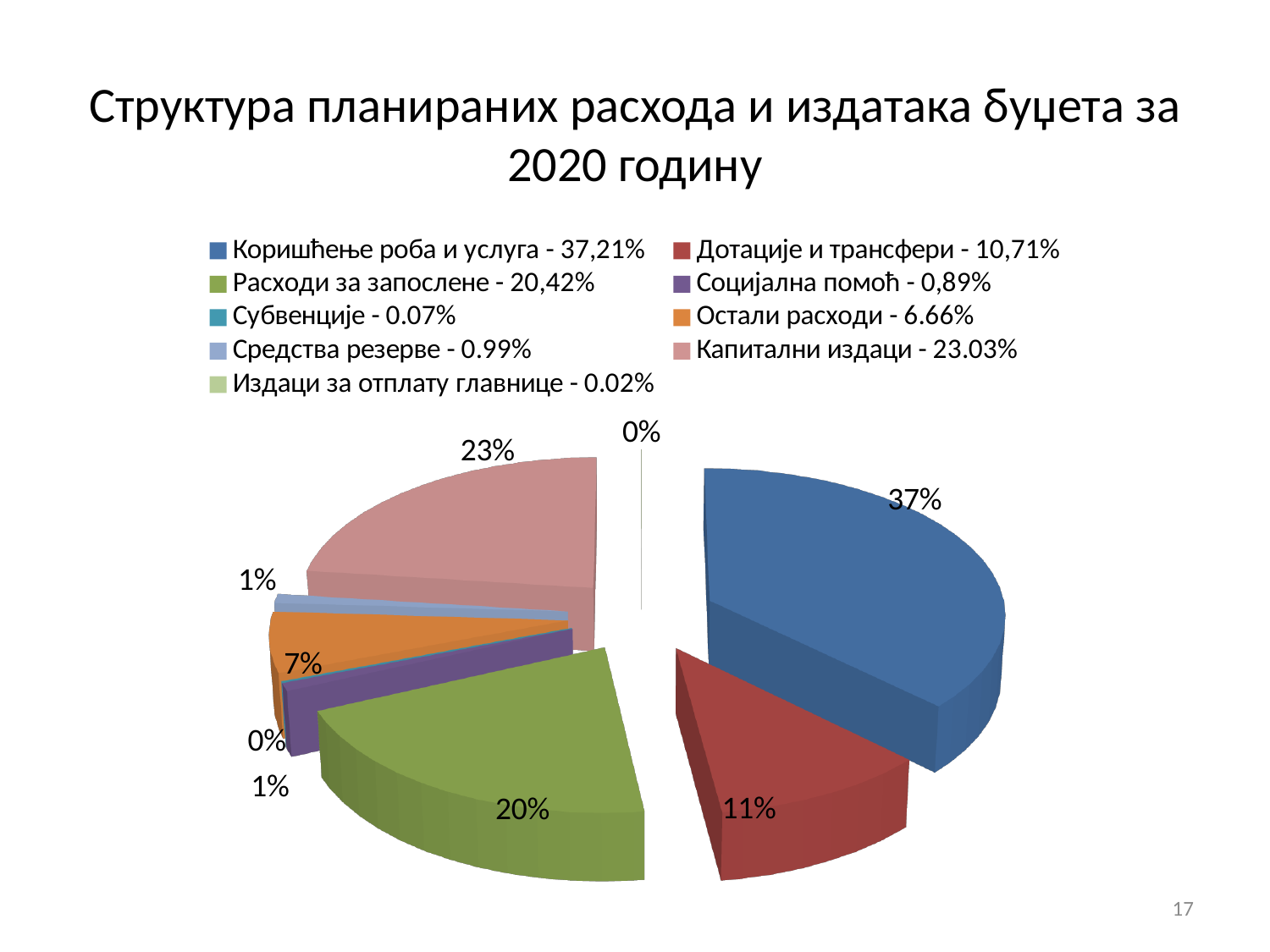
Using the labels on the pie, what is the difference between the Коришћење роба и услуга slice and the Капитални издаци slice? 14% How many categories does the legend of the pie chart list? 9 What percentage label is shown on the pie slice for Коришћење роба и услуга? 37% What percentage label is shown on the pie slice for Расходи за запослене? 20% What type of chart is shown on the slide? pie chart Which category has the largest share of the pie? Коришћење роба и услуга What is the title of the chart slide? Структура планираних расхода и издатака буџета за 2020 годину Which slice is larger: Расходи за запослене or Дотације и трансфери? Расходи за запослене According to the legend, what share is given for Остали расходи? 6.66% According to the legend, which category has the smallest share? Издаци за отплату главнице What percentage label is shown on the pie slice for Капитални издаци? 23% What percentage label is shown on the pie slice for Дотације и трансфери? 11%